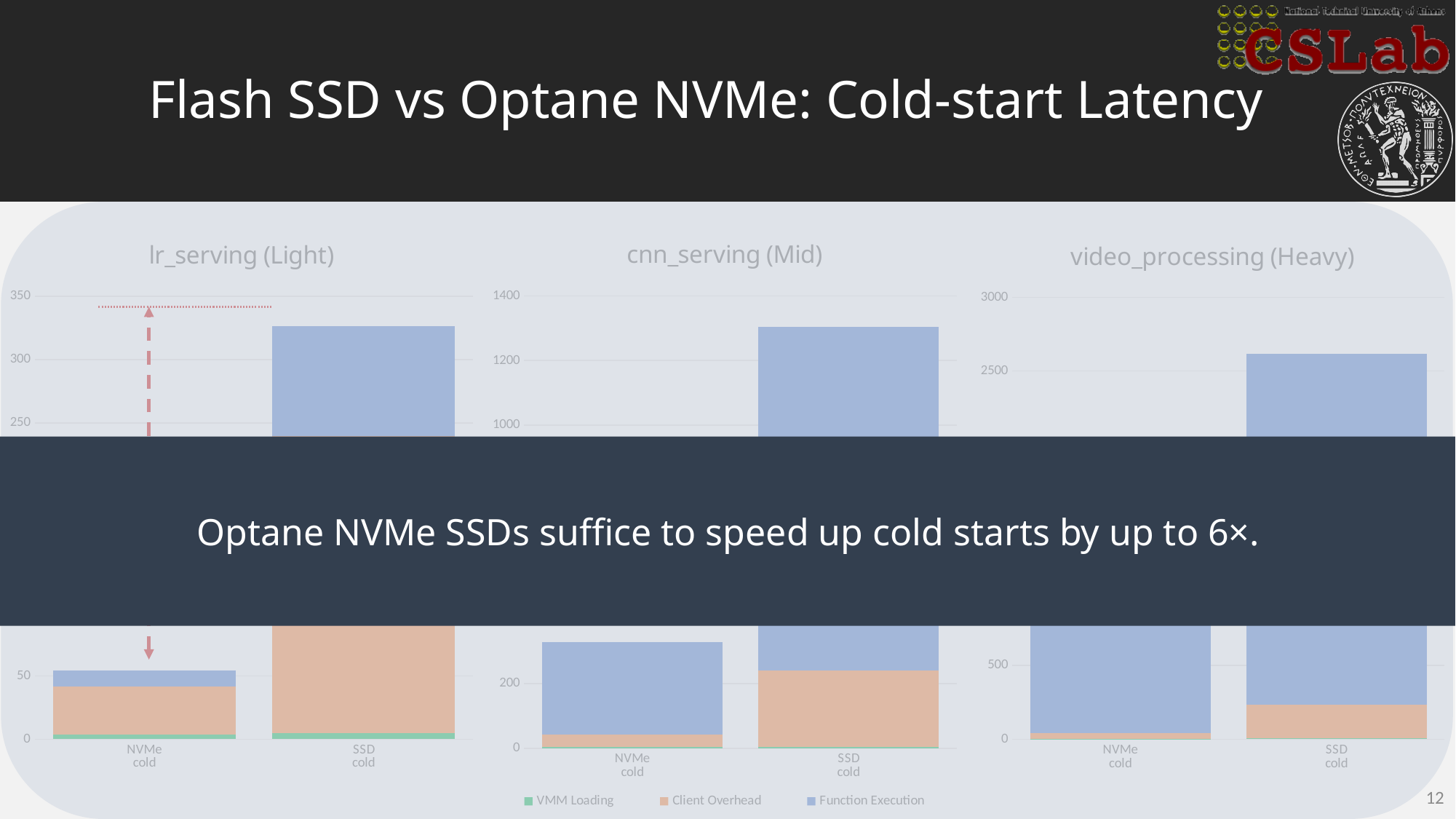
In the cnn_serving (Mid) chart, is the total for SSD cold greater or less than 1200? greater What kind of chart is the lr_serving (Light) chart? bar chart In the lr_serving (Light) chart, is the total for NVMe cold greater or less than 250? less In the lr_serving (Light) chart, which bar is taller, NVMe cold or SSD cold? SSD cold How many categories are shown on the x axis of the cnn_serving (Mid) chart? 2 In the cnn_serving (Mid) chart, which category has the lowest total bar? NVMe cold In the video_processing (Heavy) chart, is the total for SSD cold greater or less than 2500? greater In the video_processing (Heavy) chart, which category has the highest total bar? SSD cold What are the three series named in the legend? VMM Loading, Client Overhead, Function Execution How many series does the legend list for the charts? 3